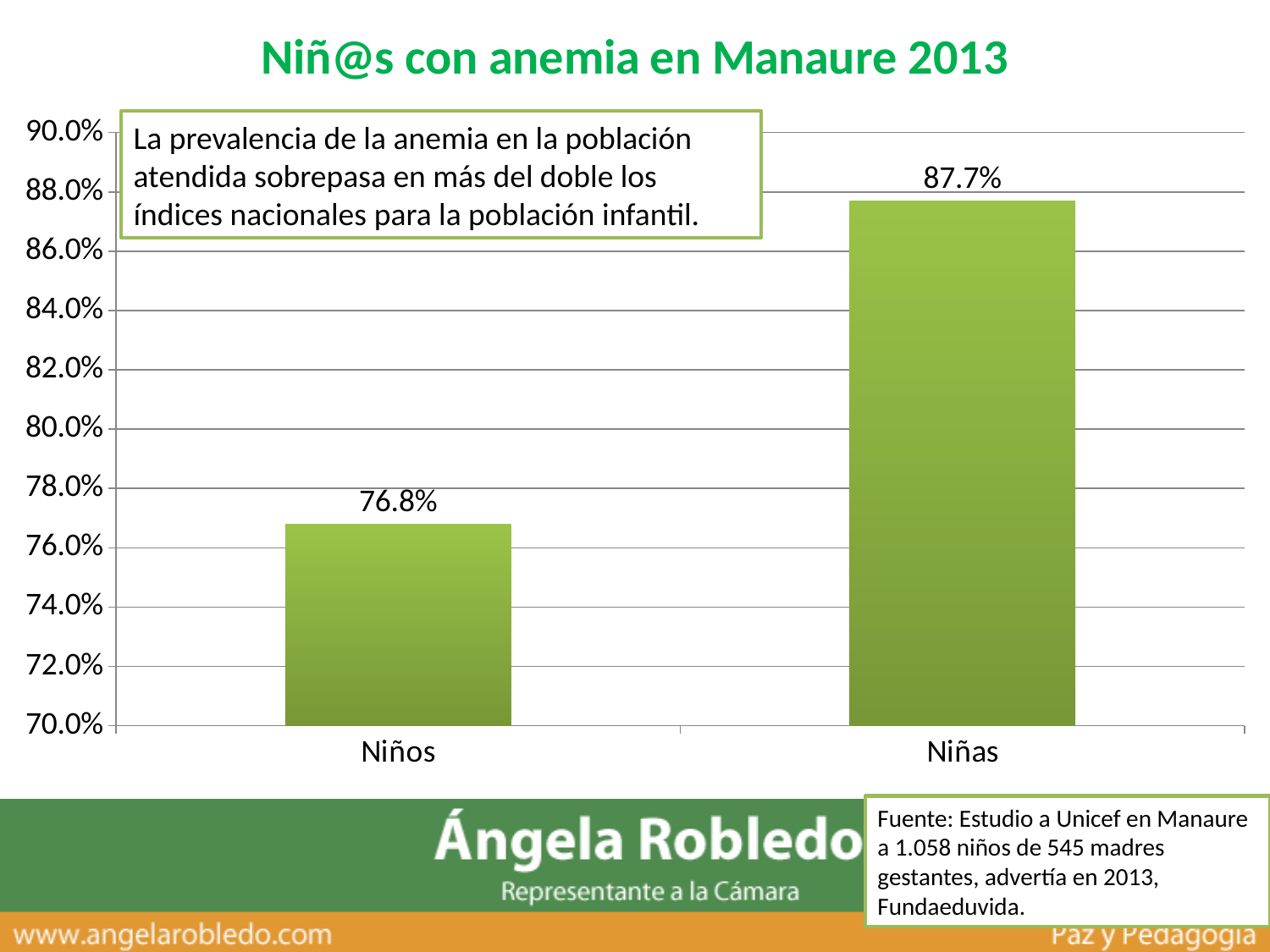
What is the title of the chart? Niñ@s con anemia en Manaure 2013 Which category has the lowest value? Niños Is the value for Niños greater or less than 80.0%? less What kind of chart is shown on the slide? bar chart What is the difference between the values for Niñas and Niños? 10.9% Which category has the highest value? Niñas What is the lowest value shown on the y axis? 70.0% What is the value for Niñas? 87.7% What is the value for Niños? 76.8% How many categories are shown on the x axis? 2 Is the value for Niñas greater or less than 86.0%? greater Which is larger, the value for Niños or the value for Niñas? Niñas